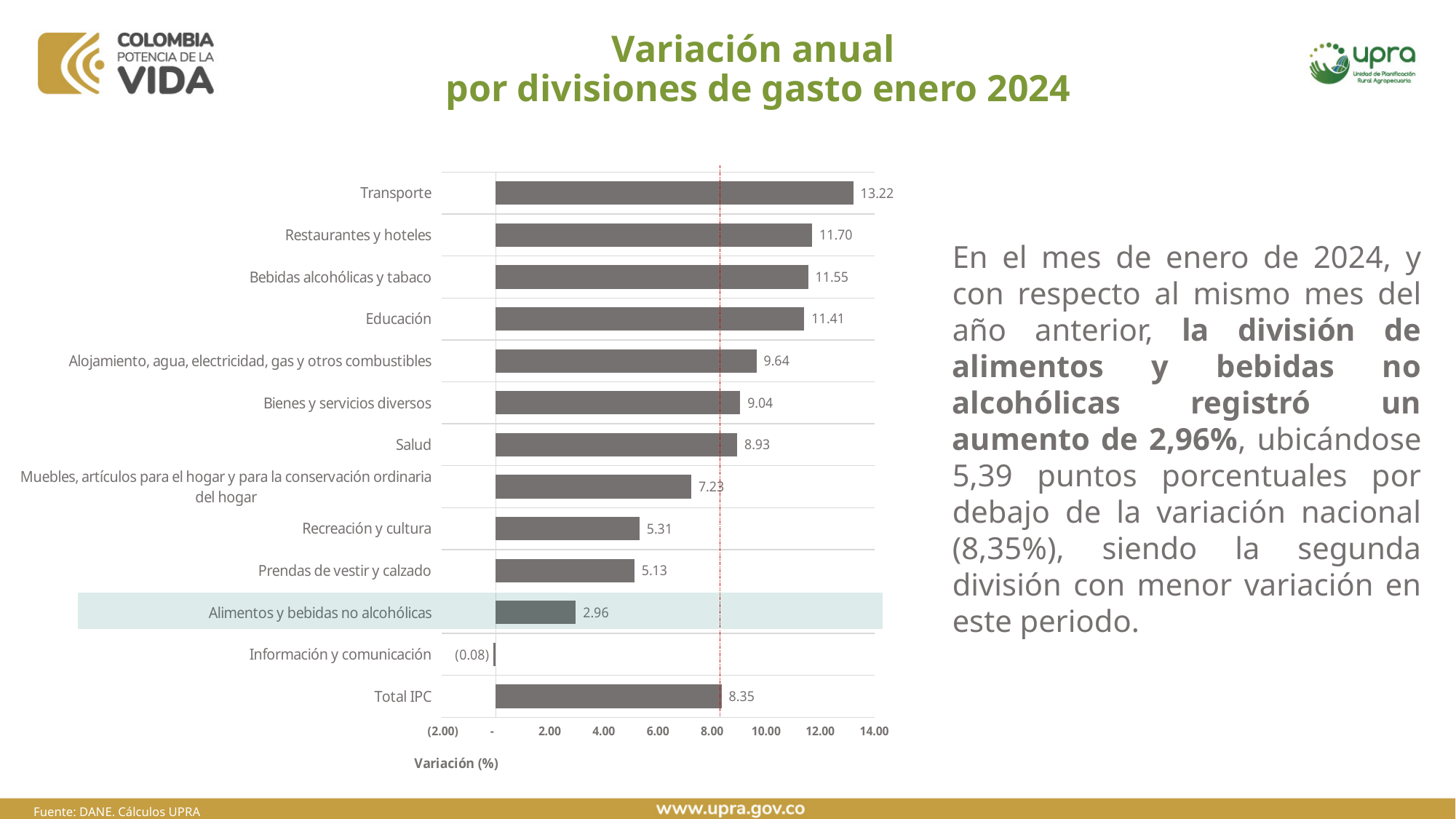
What is the difference between the values for Transporte and Restaurantes y hoteles? 1.52 What is the title of the horizontal axis? Variación (%) Is the value for Educación greater or less than 10.00? greater What is the value for Información y comunicación? (0.08) What is the value for Transporte? 13.22 Which is larger, the value for Recreación y cultura or the value for Prendas de vestir y calzado? Recreación y cultura How many bars are shown in the chart? 13 Which category has the highest value? Transporte What is the value for Alimentos y bebidas no alcohólicas? 2.96 What is the value for Total IPC? 8.35 Which category has the lowest value? Información y comunicación What kind of chart is shown on the slide? bar chart